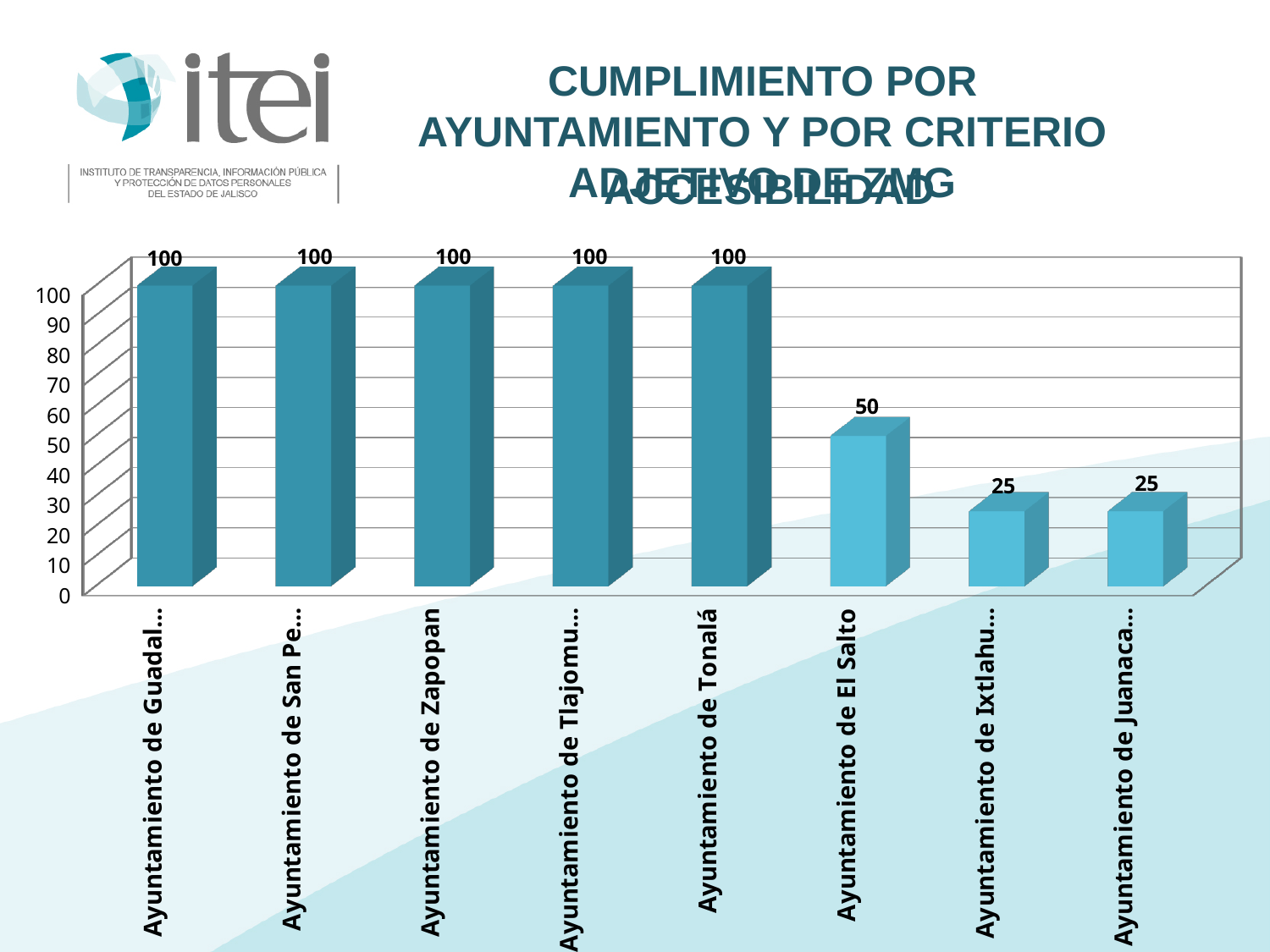
How many bars have a value of 100? 5 What is the difference between the values for Ayuntamiento de Tonalá and Ayuntamiento de El Salto? 50 Which is larger, the value for Ayuntamiento de Zapopan or the value for Ayuntamiento de El Salto? Ayuntamiento de Zapopan What is the value for Ayuntamiento de El Salto? 50 What kind of chart is shown on the slide? Bar chart What is the value of the last bar on the right (Ayuntamiento de Juanaca…)? 25 How many categories (bars) are shown in the chart? 8 What is the difference between the values for Ayuntamiento de El Salto and Ayuntamiento de Juanaca…? 25 Which category has the lowest value, Ayuntamiento de El Salto or Ayuntamiento de Ixtlahu…? Ayuntamiento de Ixtlahu… Is the value for Ayuntamiento de El Salto greater or less than 40? greater What is the value for Ayuntamiento de Tonalá? 100 What is the value for Ayuntamiento de Zapopan? 100